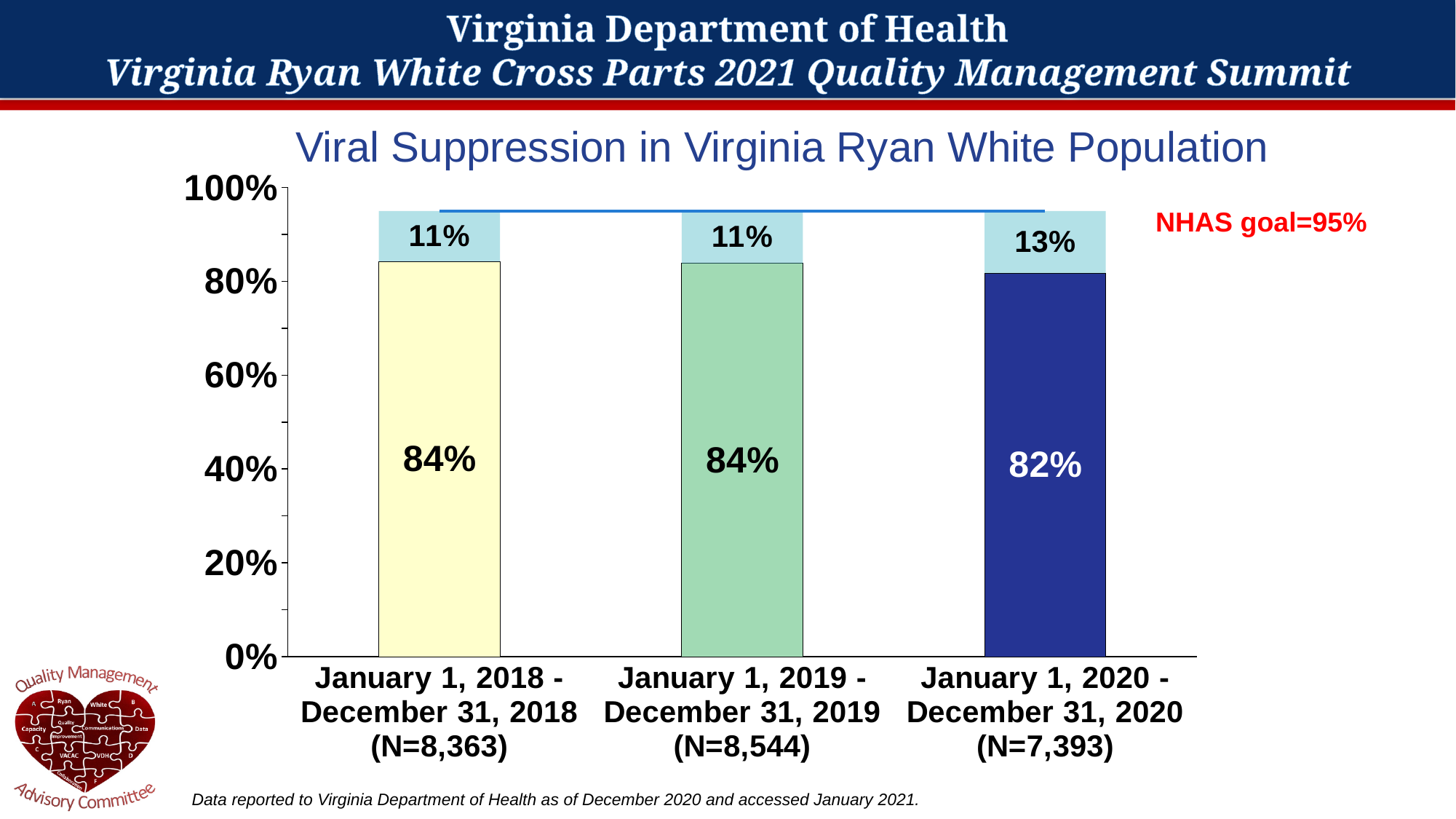
What is the total of the stacked bar for January 1, 2018 - December 31, 2018? 95% How many time periods are shown on the x axis? 3 What is the value of the light blue top segment for January 1, 2020 - December 31, 2020? 13% What is the value of the light blue top segment for January 1, 2019 - December 31, 2019? 11% What kind of chart is shown on the slide? Stacked bar chart What is the NHAS goal shown on the chart? 95% What is the viral suppression percentage for January 1, 2020 - December 31, 2020? 82% What is the difference between the viral suppression percentage for 2019 and for 2020? 2% What is the N value for January 1, 2019 - December 31, 2019? N=8,544 What is the viral suppression percentage for January 1, 2018 - December 31, 2018? 84% Is the viral suppression percentage for 2018 larger or smaller than for 2020? larger Which period has the lowest viral suppression percentage? January 1, 2020 - December 31, 2020